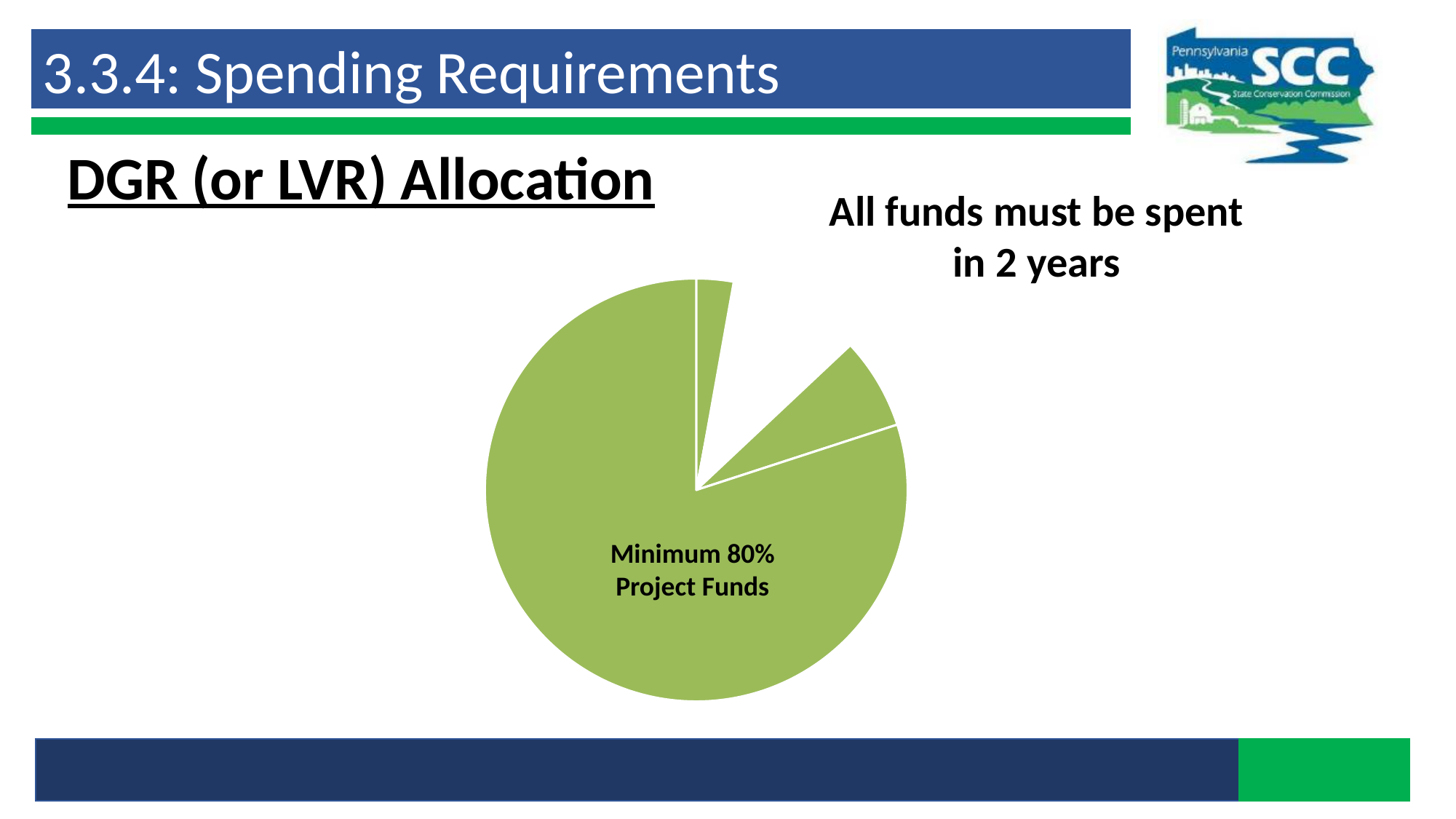
Is the Project Funds slice greater or less than half of the pie? greater What kind of chart is shown on the slide? pie chart How many slices of the pie chart carry a printed label? 1 How many slices does the pie chart have? 5 What heading appears above the pie chart on the left of the slide? DGR (or LVR) Allocation What share of the pie is indicated for Project Funds? Minimum 80% What label is printed on the largest slice of the pie chart? Minimum 80% Project Funds Which slice of the pie chart is the largest? Minimum 80% Project Funds What colour are the slices of the pie chart? green